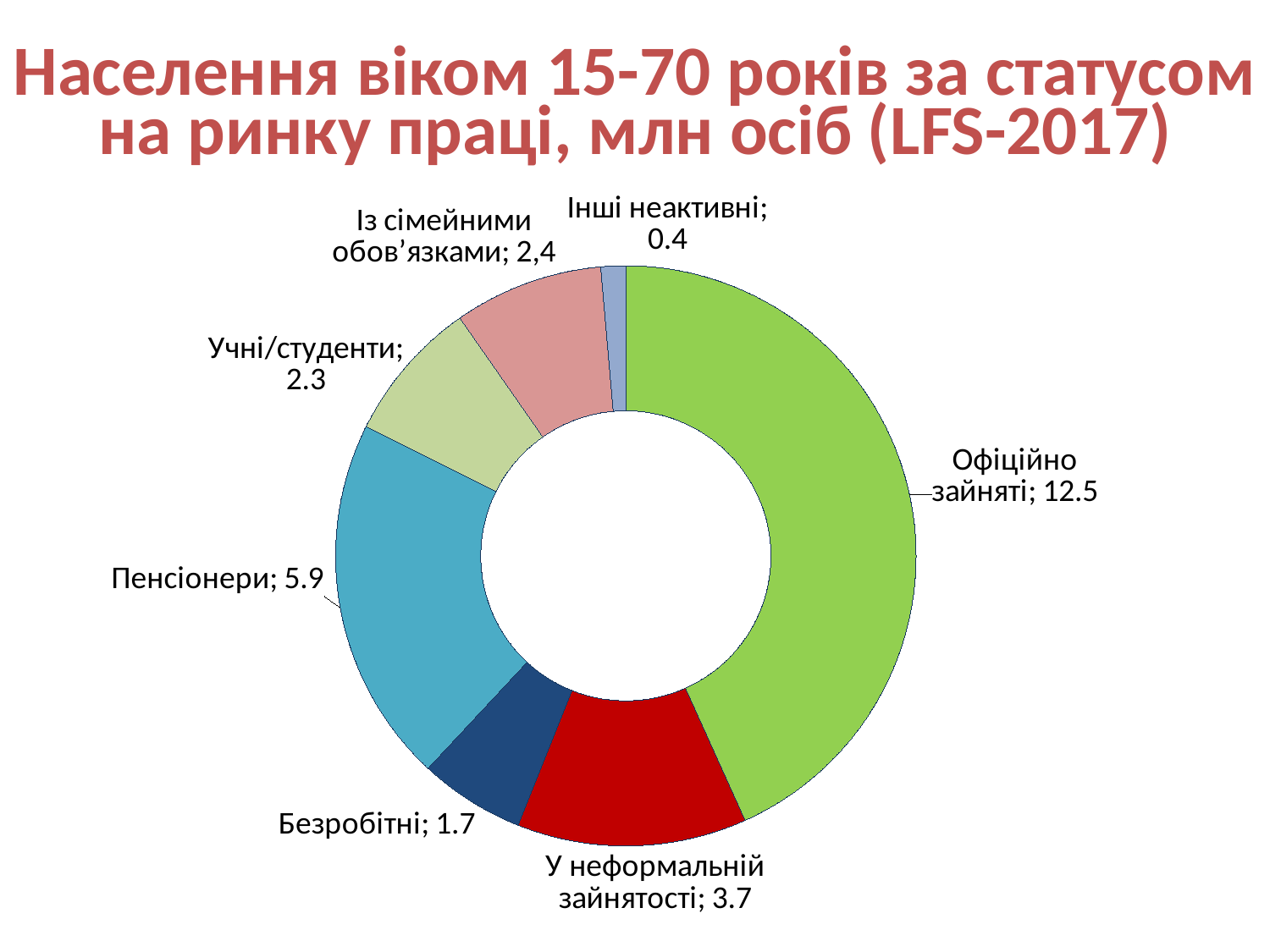
What kind of chart is shown on the slide? doughnut chart What is the difference between У неформальній зайнятості and Безробітні? 2.0 What is the value for Пенсіонери? 5.9 What is the value for Безробітні? 1.7 How many categories are shown in the chart? 7 What is the difference between Офіційно зайняті and Пенсіонери? 6.6 What is the value for У неформальній зайнятості? 3.7 What is the value for Інші неактивні? 0.4 Which is larger, Пенсіонери or У неформальній зайнятості? Пенсіонери Which category has the largest value? Офіційно зайняті What is the value for Офіційно зайняті? 12.5 Which category has the smallest value? Інші неактивні